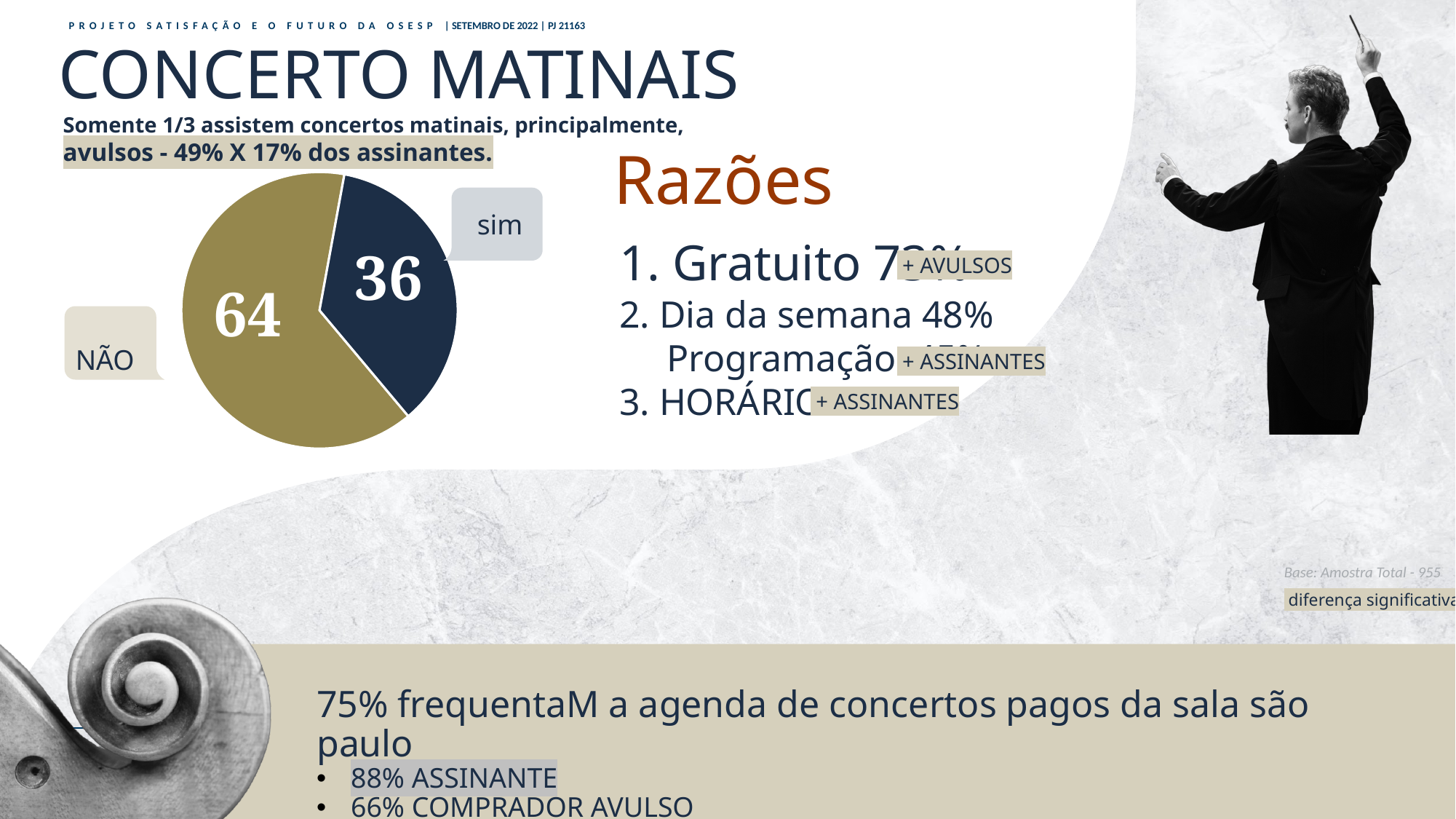
What colour is the "NÃO" slice of the pie chart? olive gold What is the value shown for the "sim" slice of the pie chart? 36 What is the total of the two values shown in the pie chart? 100 What kind of chart is shown on the slide? pie chart Which slice of the pie chart is the largest? NÃO What is the difference between the "NÃO" and "sim" values in the pie chart? 28 Which is larger in the pie chart, "sim" or "NÃO"? NÃO What colour is the "sim" slice of the pie chart? dark navy blue What is the value shown for the "NÃO" slice of the pie chart? 64 Which slice of the pie chart is the smallest? sim How many slices does the pie chart have? 2